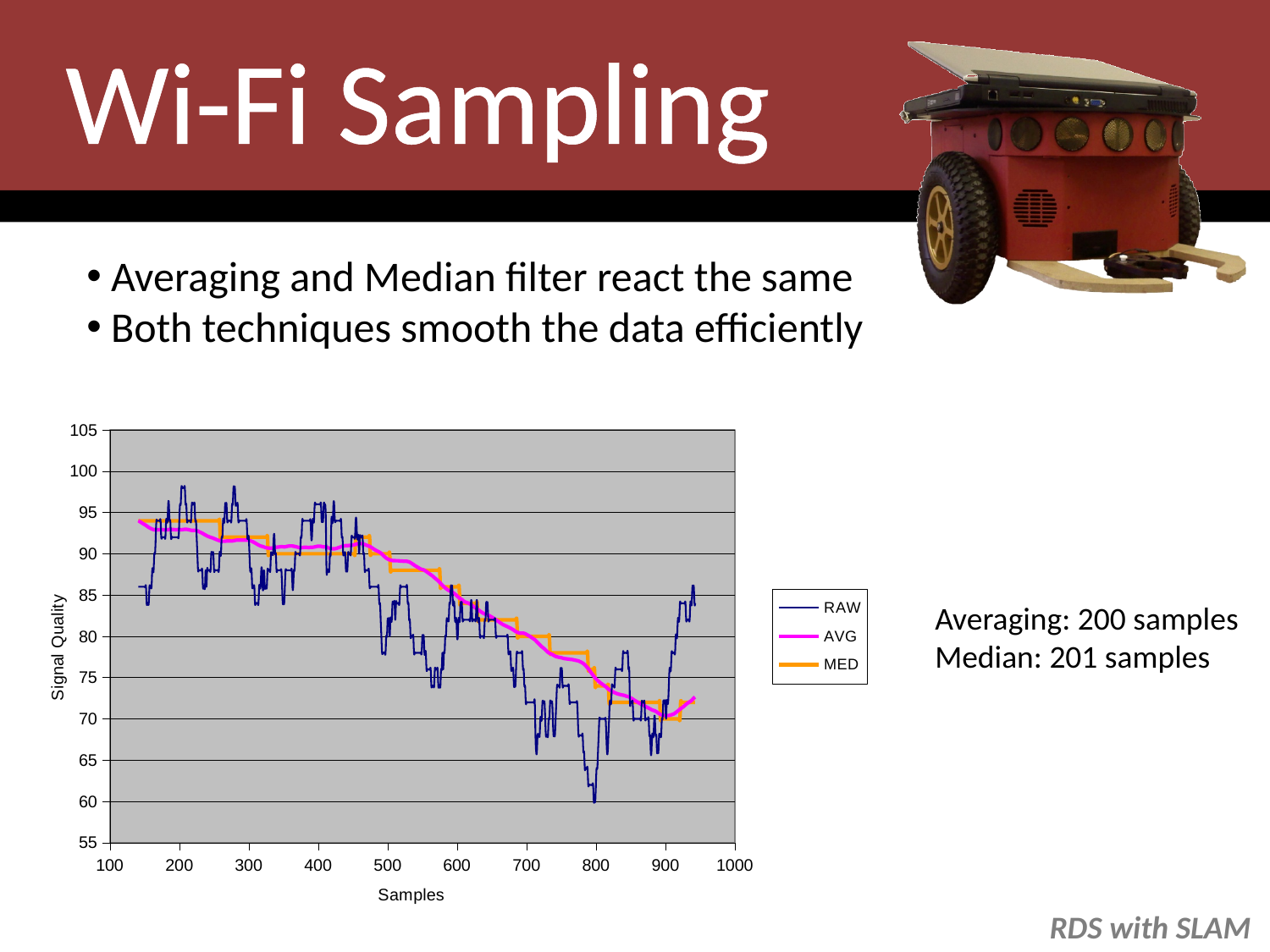
Is the AVG value at sample 900 greater or less than 75? less Is the lowest point of the RAW line greater or less than 65? less How many series does the chart's legend list? 3 At sample 200, is the AVG value greater or less than the RAW value's lowest point near sample 800? greater Is the AVG value at sample 200 greater or less than 90? greater What are the three series named in the chart's legend? RAW, AVG, MED What is the label of the chart's vertical axis? Signal Quality What kind of chart is shown on the slide? line chart Does the AVG line generally rise or fall between samples 200 and 900? fall At sample 800, is the RAW value larger or smaller than the AVG value? smaller